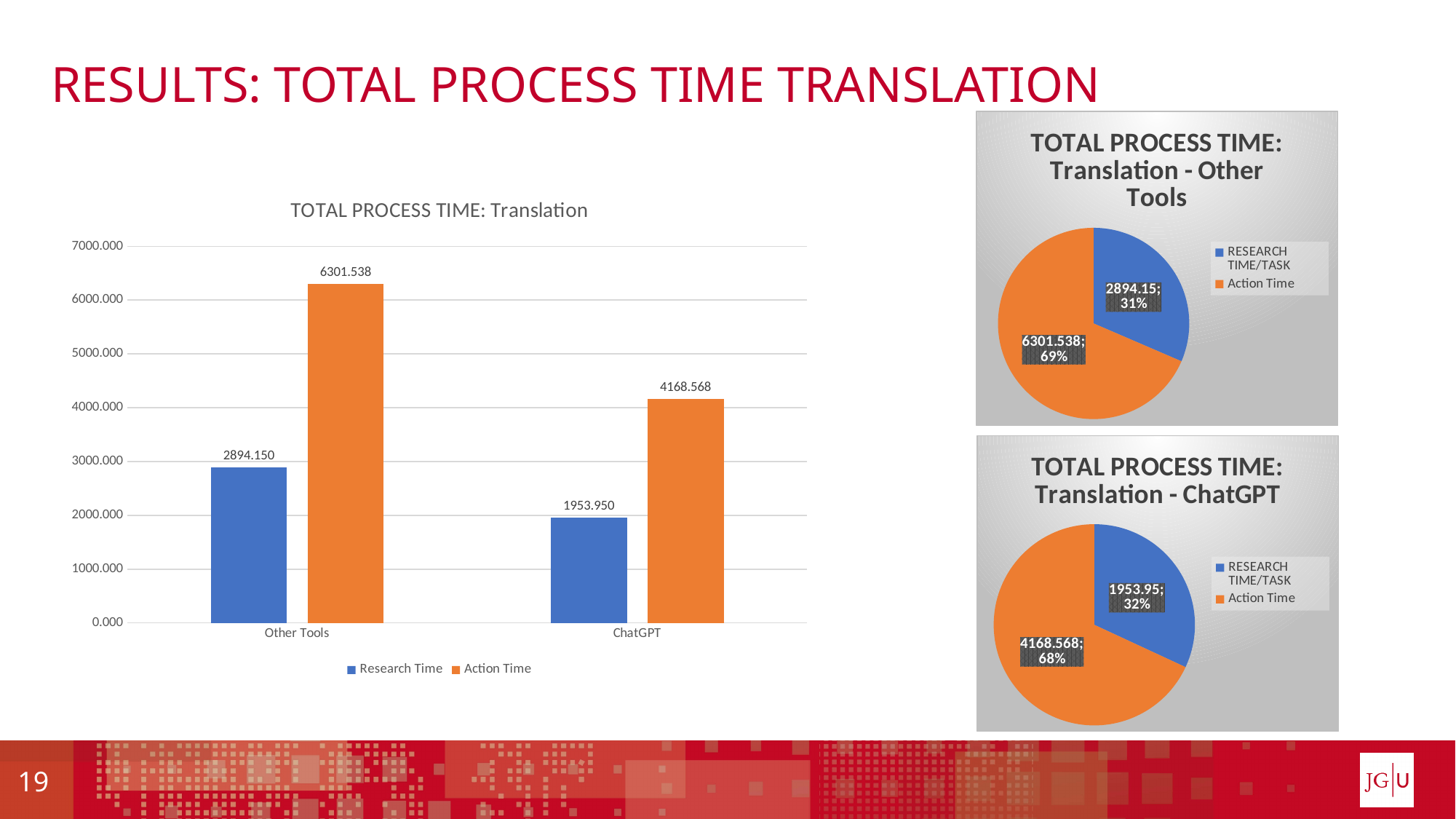
In the bar chart 'TOTAL PROCESS TIME: Translation', which bar is the shortest? Research Time for ChatGPT In the bar chart 'TOTAL PROCESS TIME: Translation', how much higher is the Research Time for Other Tools than for ChatGPT? 940.200 In the pie chart 'TOTAL PROCESS TIME: Translation - ChatGPT', what colour is the Action Time slice? orange In the bar chart 'TOTAL PROCESS TIME: Translation', is the Action Time for ChatGPT greater or less than 4000.000? greater In the bar chart 'TOTAL PROCESS TIME: Translation', what is the Research Time value for ChatGPT? 1953.950 In the bar chart 'TOTAL PROCESS TIME: Translation', what is the difference between Action Time and Research Time for ChatGPT? 2214.618 In the bar chart 'TOTAL PROCESS TIME: Translation', what is the Action Time value for Other Tools? 6301.538 In the bar chart 'TOTAL PROCESS TIME: Translation', which bar is the tallest? Action Time for Other Tools What kind of chart is 'TOTAL PROCESS TIME: Translation' on the left of the slide? bar chart In the pie chart 'TOTAL PROCESS TIME: Translation - ChatGPT', what share does RESEARCH TIME/TASK have? 32% In the pie chart 'TOTAL PROCESS TIME: Translation - Other Tools', what share does Action Time have? 69% In the bar chart 'TOTAL PROCESS TIME: Translation', how many series does the legend list? 2